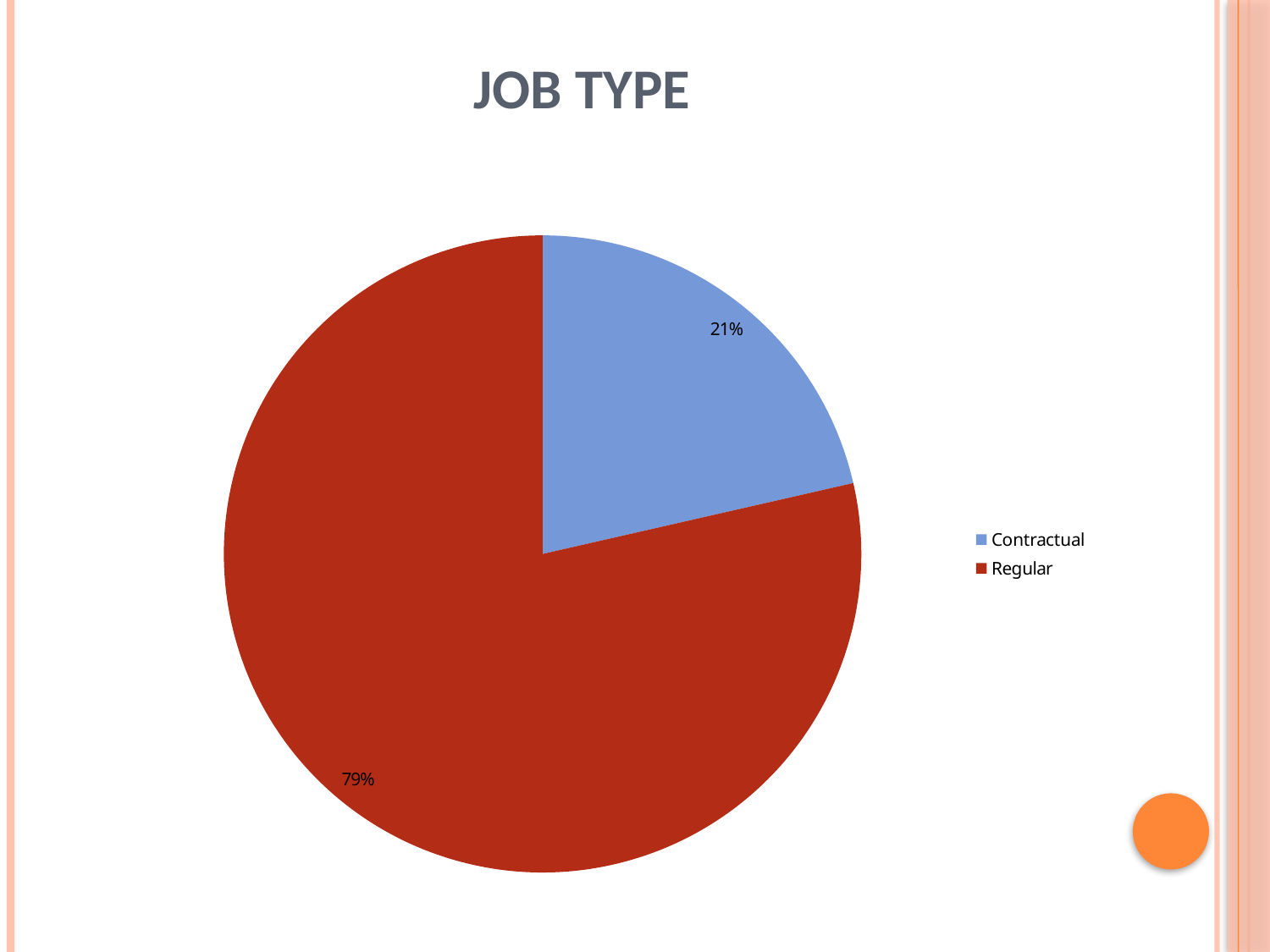
Which job type has the largest slice of the pie? Regular What is the difference in percentage points between the Regular and Contractual slices? 58 What share of the pie does Contractual represent? 21% How many entries does the legend list? 2 What is the title of the chart? JOB TYPE Which job type has the smallest slice of the pie? Contractual How many categories does the pie chart show? 2 What share of the pie does Regular represent? 79% What kind of chart is shown on the slide? pie chart Which is larger, the Contractual slice or the Regular slice? Regular What colour is the Regular slice? red